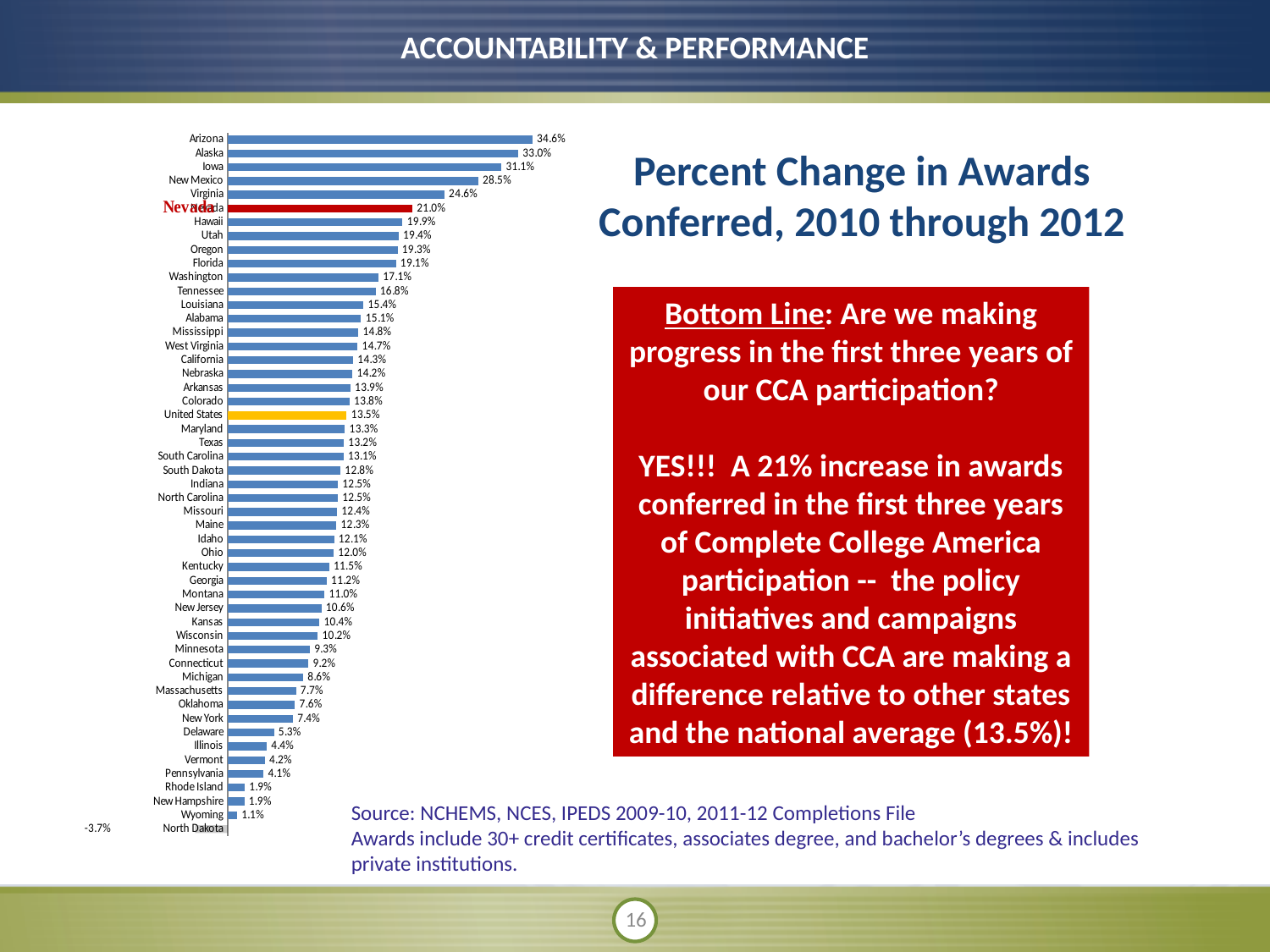
What kind of chart is shown on the slide? Bar chart How many bars are plotted in the chart? 51 What is the percent change in awards conferred for the United States overall? 13.5% What colour is the bar for Nevada? Red Which state has the highest percent change in awards conferred? Arizona How many percentage points higher is Nevada's percent change than the United States value? 7.5 What is the percent change in awards conferred for Arizona? 34.6% Do the values rise or fall moving from the top bar to the bottom bar? Fall What is the percent change in awards conferred for Nevada? 21.0% Which state has the lowest percent change in awards conferred? North Dakota What is the percent change in awards conferred for North Dakota? -3.7% Which has a larger percent change in awards conferred, Hawaii or Utah? Hawaii